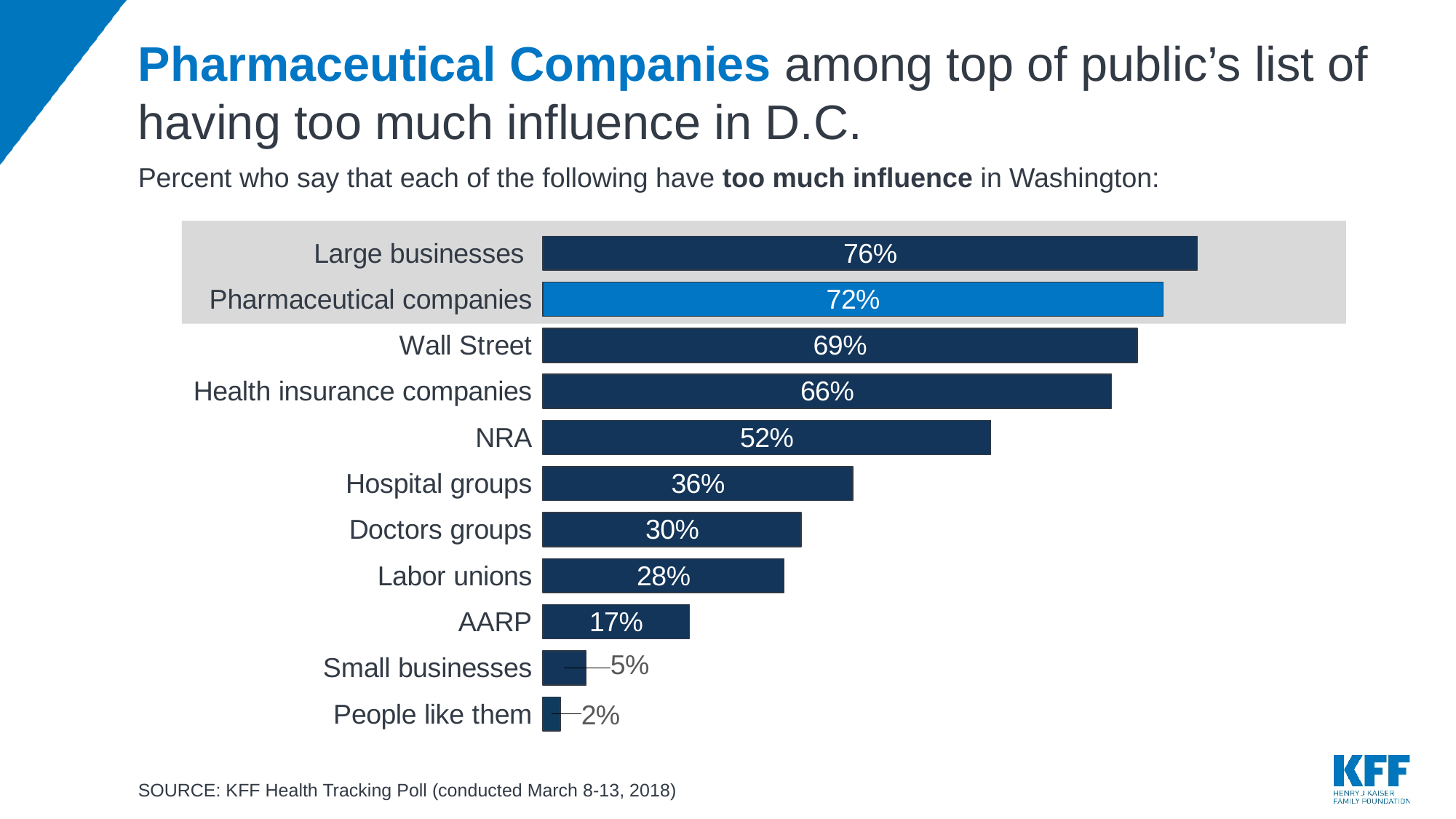
What percent say the NRA has too much influence? 52% What is the difference between the values for Hospital groups and Doctors groups? 6 percentage points Which category has the highest value? Large businesses Which bar is shown in a lighter blue colour than the others? Pharmaceutical companies What is the value for AARP? 17% What percent say pharmaceutical companies have too much influence in Washington? 72% What is the difference between the values for Large businesses and Pharmaceutical companies? 4 percentage points How many categories are shown in the chart? 11 Which category has the lowest value? People like them What kind of chart is shown on the slide? Bar chart What is the value shown for Wall Street? 69% Which has a larger value, Health insurance companies or Labor unions? Health insurance companies